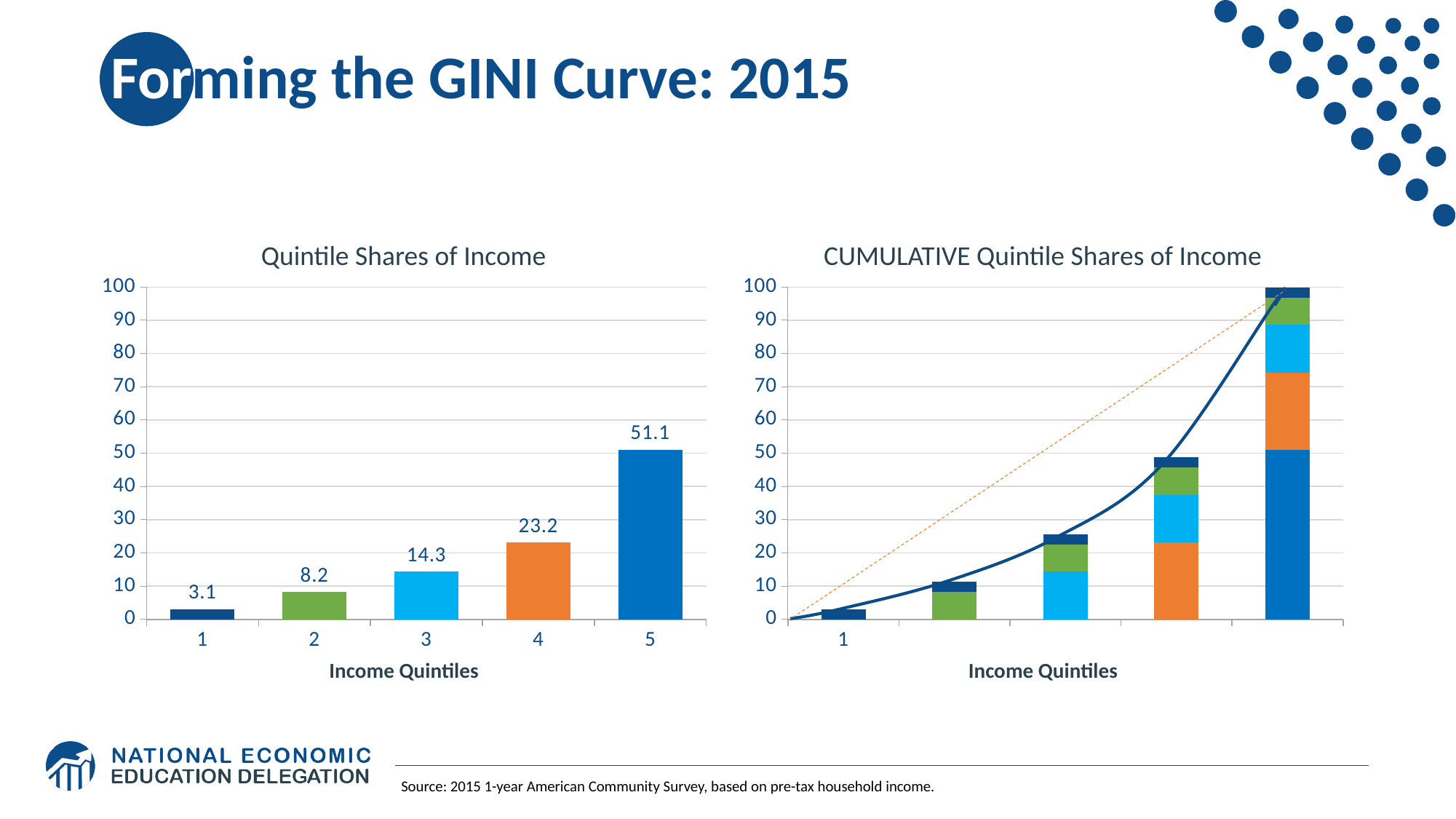
In the 'Quintile Shares of Income' chart, what is the value for income quintile 3? 14.3 In the 'Quintile Shares of Income' chart, which income quintile has the highest share? 5 What kind of chart is the 'Quintile Shares of Income' chart? Bar chart In the 'Quintile Shares of Income' chart, how many income quintiles are plotted? 5 In the 'CUMULATIVE Quintile Shares of Income' chart, is the total of the third stacked bar greater or less than 30? less In the 'Quintile Shares of Income' chart, what is the difference between the values for quintile 5 and quintile 4? 27.9 In the 'Quintile Shares of Income' chart, which is larger, the value for quintile 2 or quintile 3? Quintile 3 In the 'Quintile Shares of Income' chart, what is the value for income quintile 1? 3.1 In the 'CUMULATIVE Quintile Shares of Income' chart, is the total of the fourth stacked bar greater or less than 40? greater In the 'Quintile Shares of Income' chart, what is the value for income quintile 5? 51.1 In the 'Quintile Shares of Income' chart, do the values rise or fall from quintile 1 to quintile 5? Rise In the 'Quintile Shares of Income' chart, which income quintile has the lowest share? 1